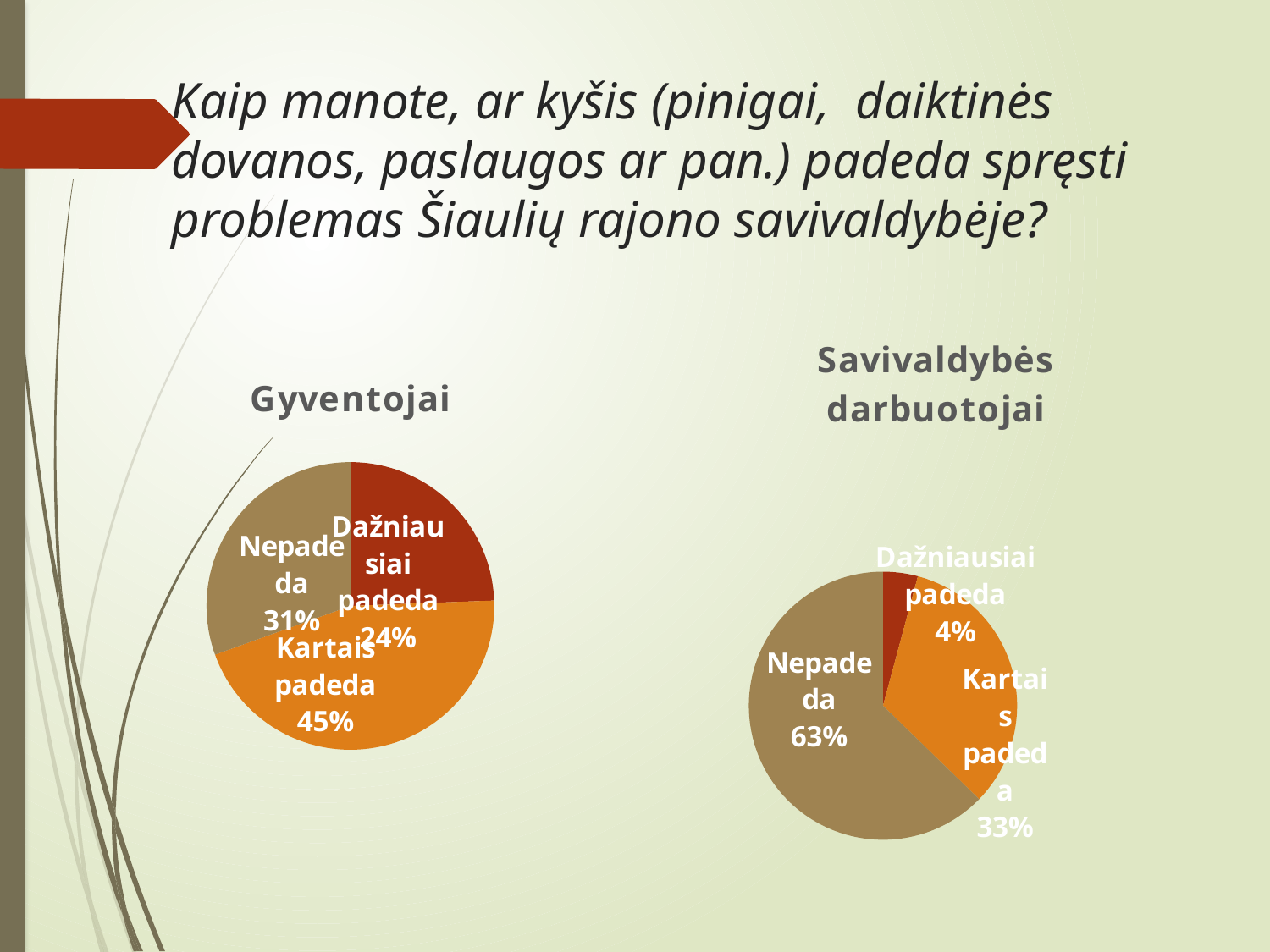
Which chart shows a larger share for "Nepadeda", "Gyventojai" or "Savivaldybės darbuotojai"? Savivaldybės darbuotojai What is the difference between the "Nepadeda" shares in the "Savivaldybės darbuotojai" and "Gyventojai" charts? 32% In the "Gyventojai" pie chart, what is the difference between the "Kartais padeda" and "Dažniausiai padeda" shares? 21% In the "Gyventojai" pie chart, what share is labelled "Kartais padeda"? 45% In the "Savivaldybės darbuotojai" pie chart, what share is labelled "Nepadeda"? 63% In the "Savivaldybės darbuotojai" pie chart, what share is labelled "Dažniausiai padeda"? 4% In the "Gyventojai" pie chart, what share is labelled "Nepadeda"? 31% In the "Gyventojai" pie chart, which category has the largest share? Kartais padeda How many slices does the "Savivaldybės darbuotojai" pie chart have? 3 In the "Savivaldybės darbuotojai" pie chart, which category has the smallest share? Dažniausiai padeda How many pie charts are shown on the slide? 2 What type of chart is used for "Gyventojai"? Pie chart